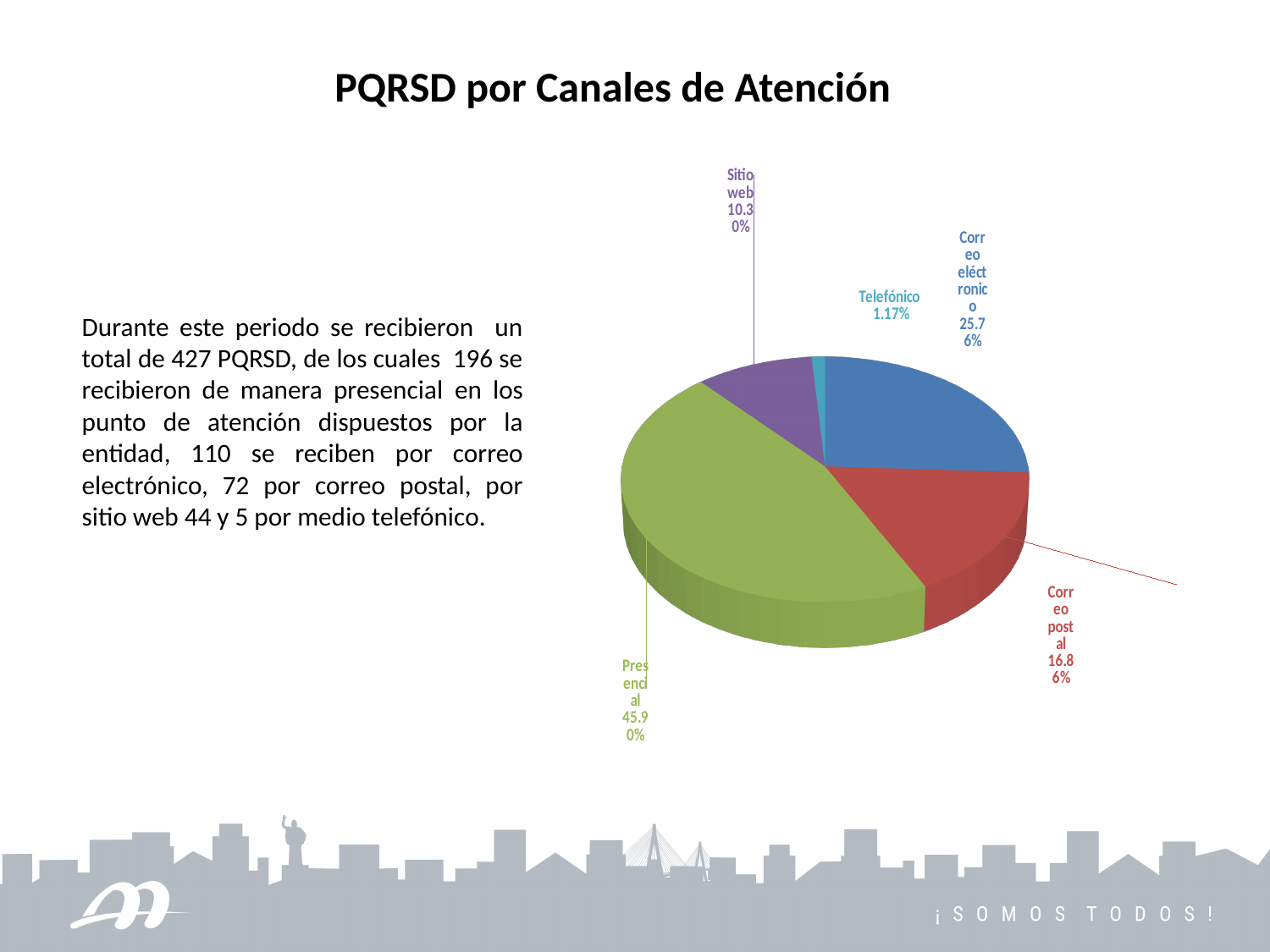
What kind of chart is shown on the slide? Pie chart What is the title of the chart on the slide? PQRSD por Canales de Atención Which channel has the largest share of the pie? Presencial What percentage is shown for Telefónico? 1.17% What percentage is shown for Correo electrónico? 25.76% What percentage is shown for Correo postal? 16.86% What share of the pie does Presencial represent? 45.90% Which channel has the smallest share of the pie? Telefónico What percentage is shown for Sitio web? 10.30% Which has a larger share, Sitio web or Correo postal? Correo postal How many percentage points larger is the Presencial share than the Correo electrónico share? 20.14 How many slices does the pie chart have? 5